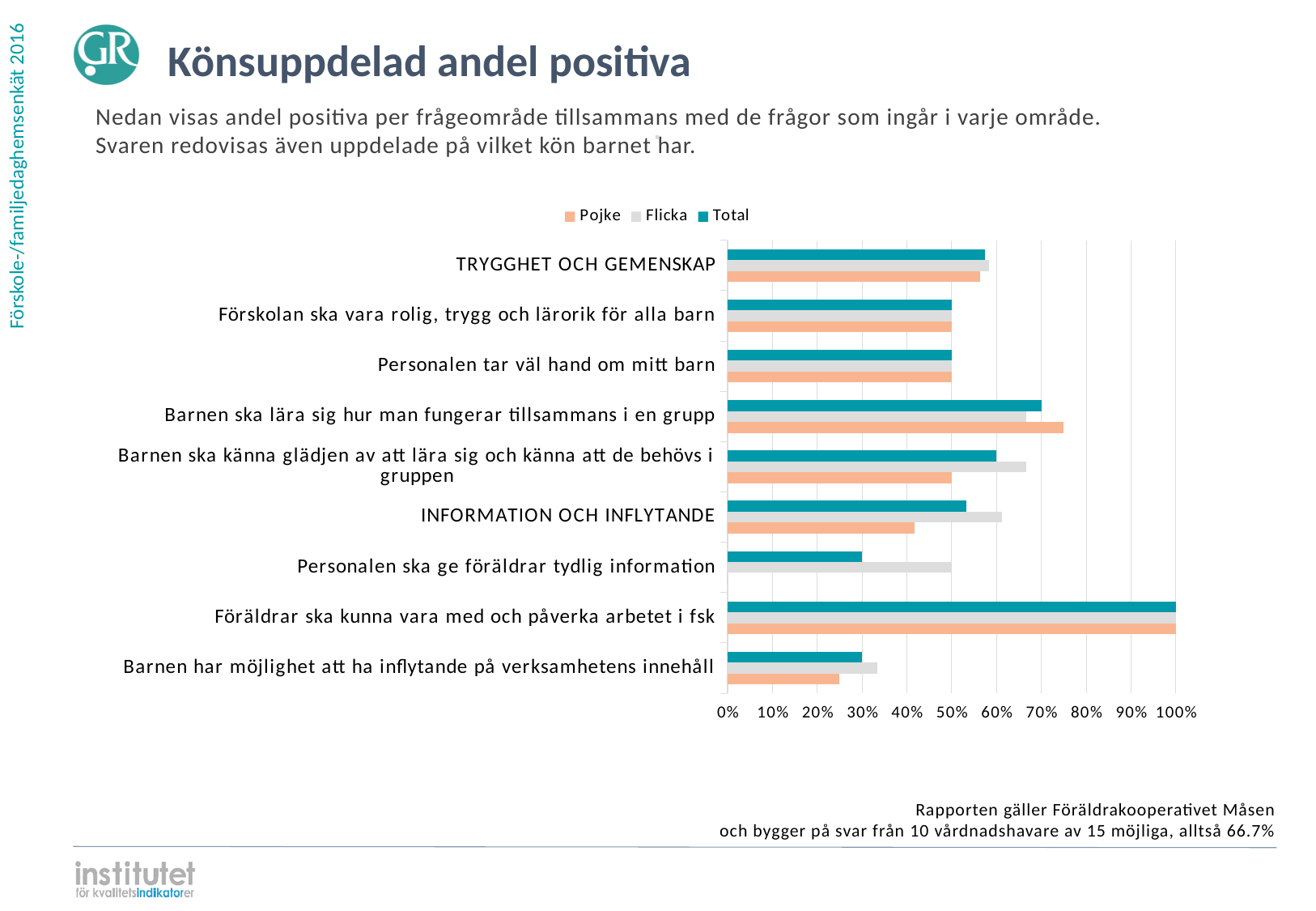
What is the Total value for 'Föräldrar ska kunna vara med och påverka arbetet i fsk'? 100% For 'Barnen ska lära sig hur man fungerar tillsammans i en grupp', which is larger, the Pojke value or the Flicka value? Pojke What kind of chart is shown on the slide? bar chart Is the Total value for 'TRYGGHET OCH GEMENSKAP' greater or less than 50%? greater What is the Flicka value for 'Personalen ska ge föräldrar tydlig information'? 50% What is the Total value for 'Barnen ska lära sig hur man fungerar tillsammans i en grupp'? 70% How many series does the legend list? 3 How many categories are shown on the chart? 9 Which category has the highest Total value? Föräldrar ska kunna vara med och påverka arbetet i fsk Is the Pojke value for 'INFORMATION OCH INFLYTANDE' greater or less than 50%? less What is the Pojke value for 'Personalen tar väl hand om mitt barn'? 50% What is the title of the chart slide? Könsuppdelad andel positiva